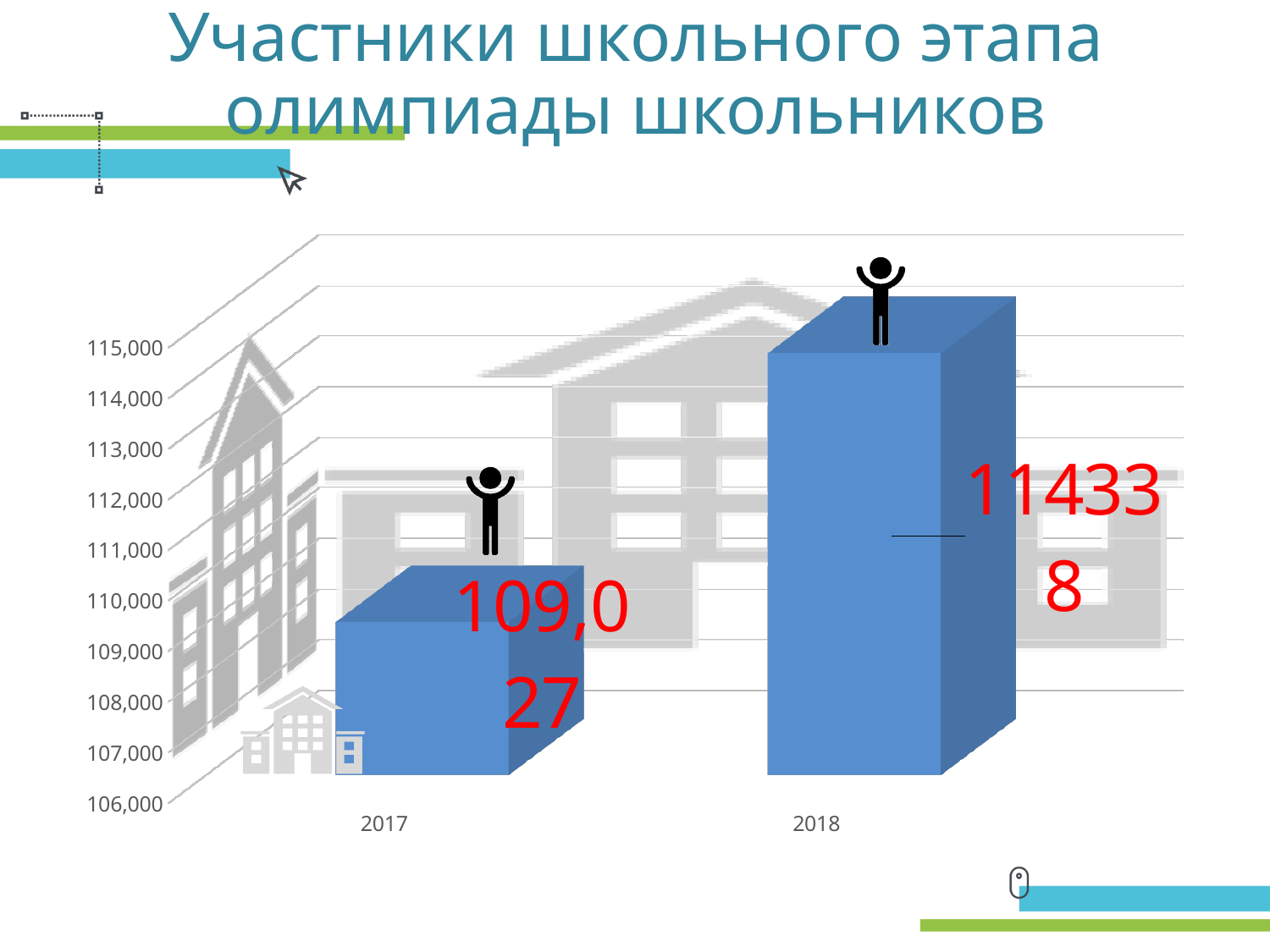
What is the value for 2018? 114338 Is the value for 2017 greater or less than 110,000? less Which year has the lowest value? 2017 What is the value for 2017? 109,027 Is the value for 2018 greater or less than 113,000? greater Which is larger, the value for 2017 or the value for 2018? 2018 What is the title of the slide? Участники школьного этапа олимпиады школьников Which year has the highest value? 2018 How many categories are shown on the x axis? 2 What kind of chart is shown on the slide? bar chart What is the difference between the values for 2018 and 2017? 5311 Do the values rise or fall from 2017 to 2018? rise